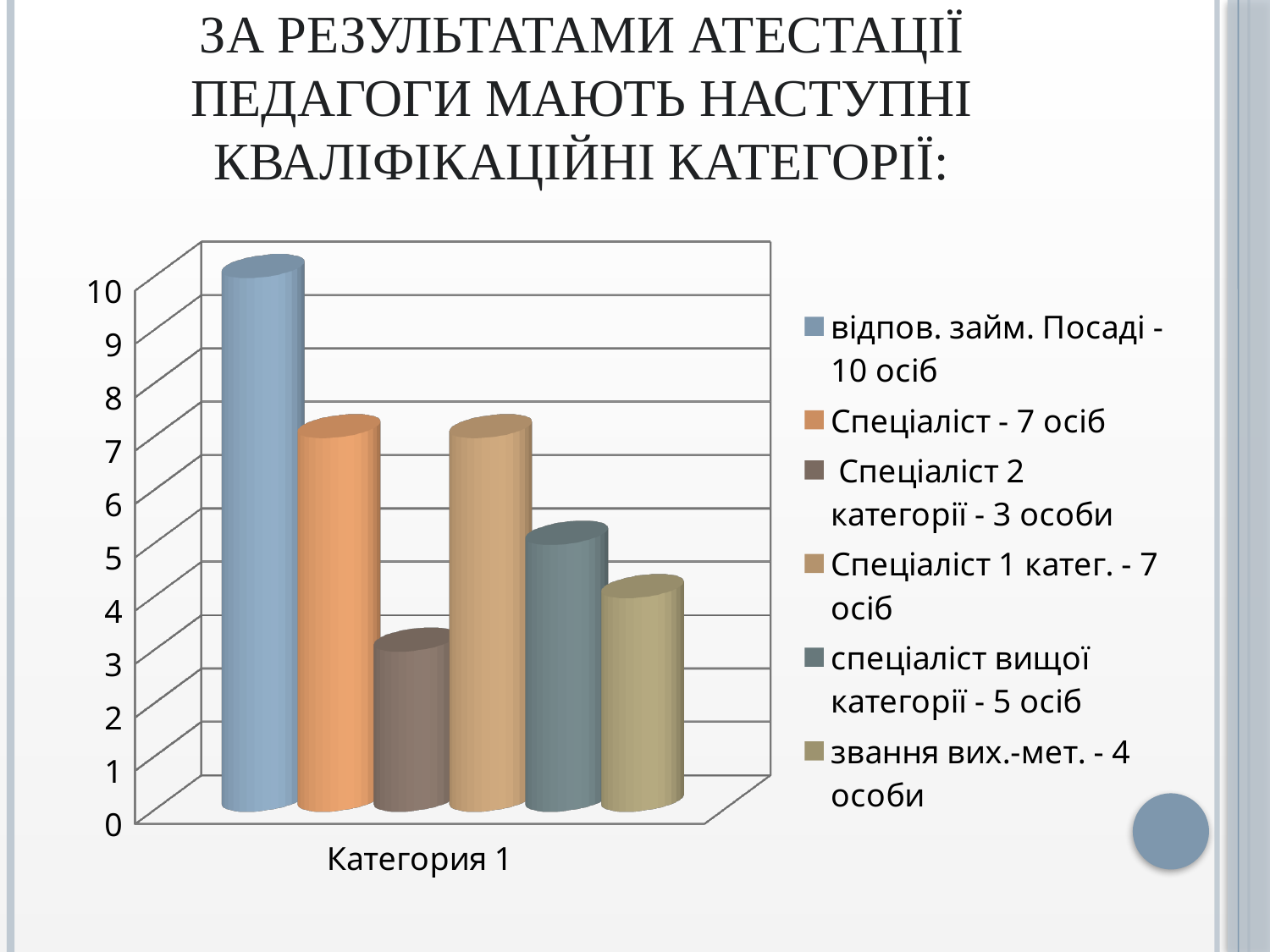
What is the difference between the 'відпов. займ. Посаді' value and the 'Спеціаліст' value? 3 What is the category label shown on the x axis? Категория 1 How many series does the legend list? 6 What kind of chart is shown on the slide? bar chart What is the difference between the 'спеціаліст вищої категорії' value and the 'Спеціаліст 2 категорії' value? 2 How many people are in the 'Спеціаліст 2 категорії' series according to the legend? 3 особи Which series has the lowest value? Спеціаліст 2 категорії - 3 особи How many people are in the 'спеціаліст вищої категорії' series according to the legend? 5 осіб How many people are in the 'відпов. займ. Посаді' series according to the legend? 10 осіб Which series has the highest value? відпов. займ. Посаді - 10 осіб How many people are in the 'звання вих.-мет.' series according to the legend? 4 особи Which is larger: the value for 'спеціаліст вищої категорії' or the value for 'звання вих.-мет.'? спеціаліст вищої категорії